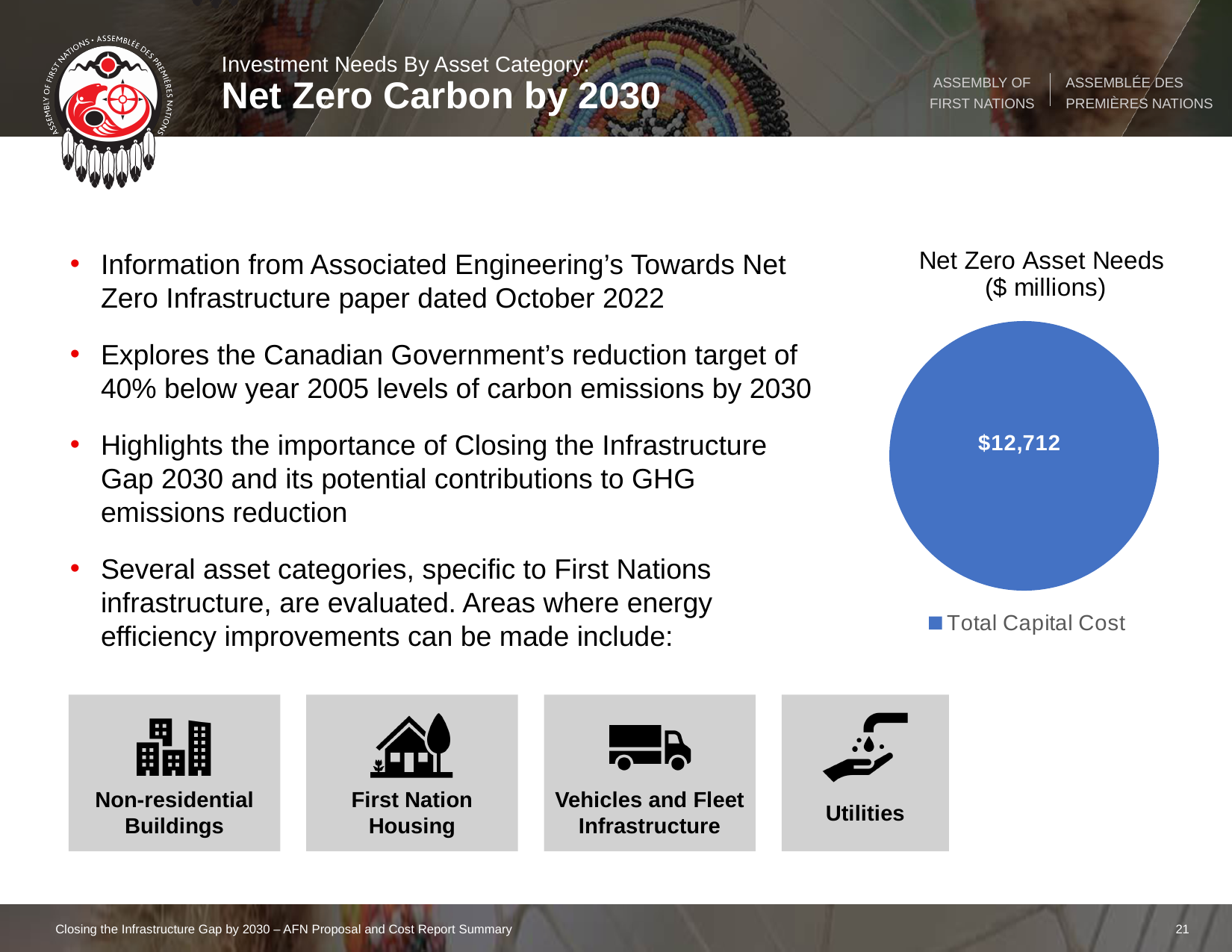
What is the value shown for Total Capital Cost in the Net Zero Asset Needs chart? $12,712 What share of the Net Zero Asset Needs pie does the Total Capital Cost slice represent? 100% What is the legend entry shown below the pie chart? Total Capital Cost How many entries does the legend of the Net Zero Asset Needs chart list? 1 What kind of chart is shown on the slide? pie chart In what units are the values of the Net Zero Asset Needs chart expressed, according to its title? $ millions How many slices does the Net Zero Asset Needs pie chart have? 1 What is the title of the chart on the slide? Net Zero Asset Needs ($ millions)